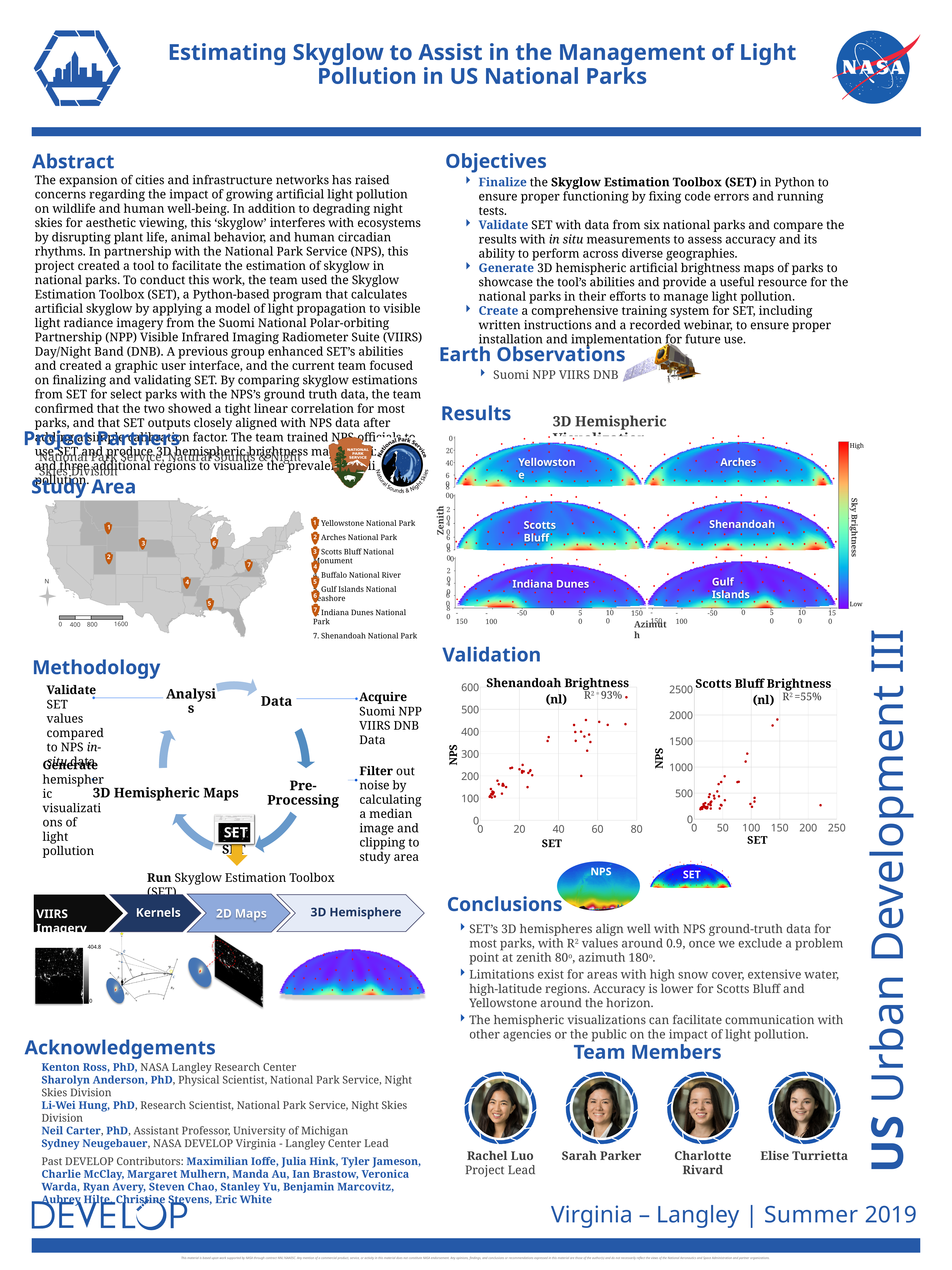
On the Shenandoah Brightness (nl) chart, do the NPS values generally rise or fall as SET increases along the x axis? rise What is the y-axis label on the Shenandoah Brightness (nl) chart? NPS On the Shenandoah Brightness (nl) chart, what is the highest tick value shown on the x axis? 80 What is the x-axis label on the Scotts Bluff Brightness (nl) chart? SET What is the difference between the R² values printed on the Shenandoah Brightness chart and the Scotts Bluff Brightness chart? 38 percentage points Which of the two validation charts, Shenandoah Brightness or Scotts Bluff Brightness, shows the higher R² value? Shenandoah Brightness On the Scotts Bluff Brightness (nl) chart, what is the highest tick value shown on the y axis? 2500 What kind of chart is the Shenandoah Brightness (nl) chart? scatter chart On the Scotts Bluff Brightness (nl) chart, what R² value is printed? 55% What kind of chart is the Scotts Bluff Brightness (nl) chart? scatter chart On the Shenandoah Brightness (nl) chart, what R² value is printed? 93%